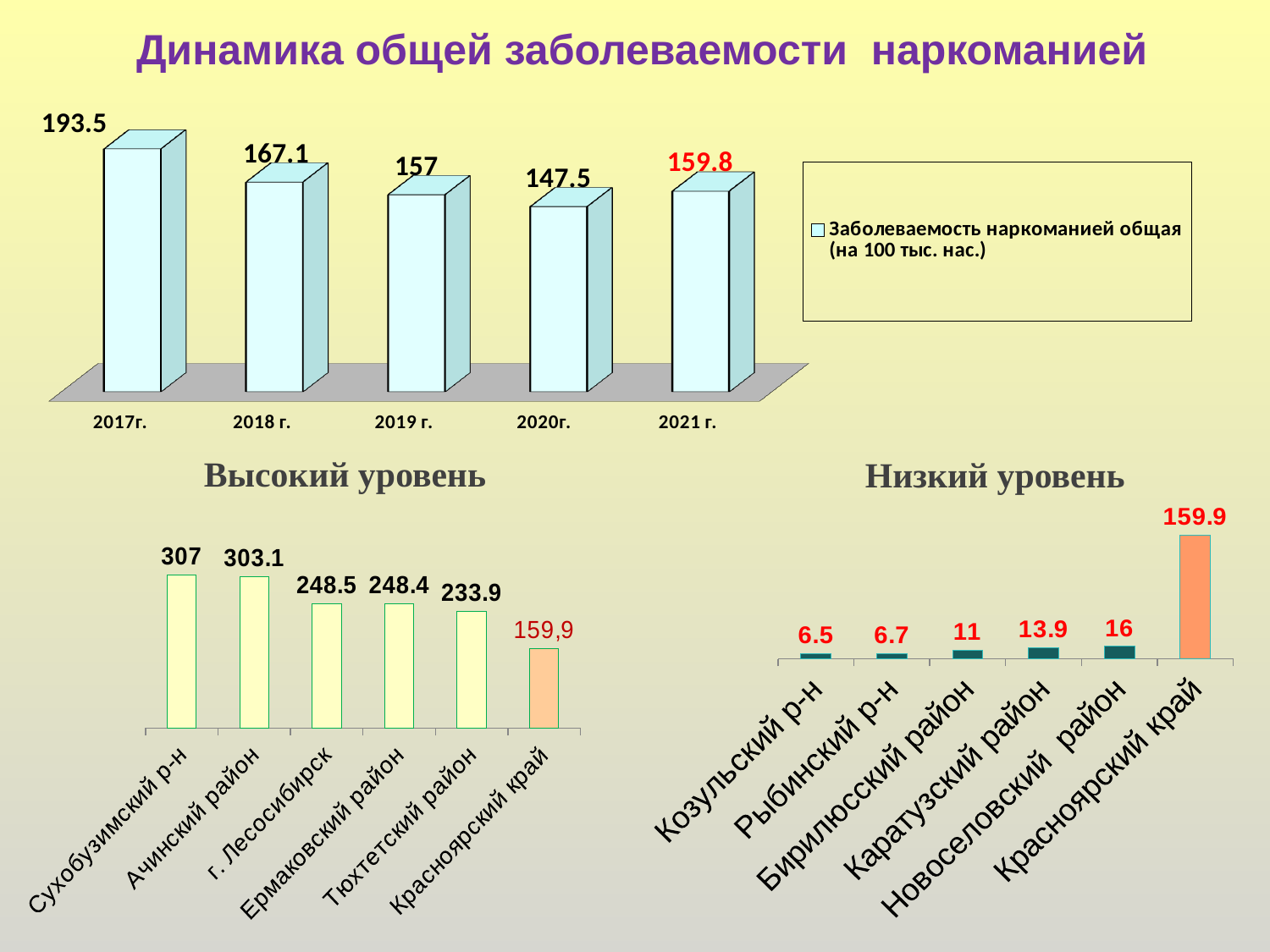
In the 'Низкий уровень' chart, which category has the lowest value? Козульский р-н In the 'Высокий уровень' chart, what is the difference between Тюхтетский район and Красноярский край? 74 In the top chart 'Динамика общей заболеваемости наркоманией', which year has the lowest value? 2020г. In the 'Высокий уровень' chart, which category has the highest value? Сухобузимский р-н In the 'Низкий уровень' chart, which is larger: Бирилюсский район or Новоселовский район? Новоселовский район In the top chart 'Динамика общей заболеваемости наркоманией', what series name does the legend show? Заболеваемость наркоманией общая (на 100 тыс. нас.) In the top chart 'Динамика общей заболеваемости наркоманией', what is the difference between the values for 2017г. and 2021 г.? 33.7 In the 'Низкий уровень' chart, what is the value for Каратузский район? 13.9 In the top chart 'Динамика общей заболеваемости наркоманией', what is the value for 2017г.? 193.5 In the top chart 'Динамика общей заболеваемости наркоманией', do the values rise or fall from 2017г. to 2020г.? fall In the top chart 'Динамика общей заболеваемости наркоманией', how many years are plotted? 5 In the 'Высокий уровень' chart, what is the value for Ачинский район? 303.1